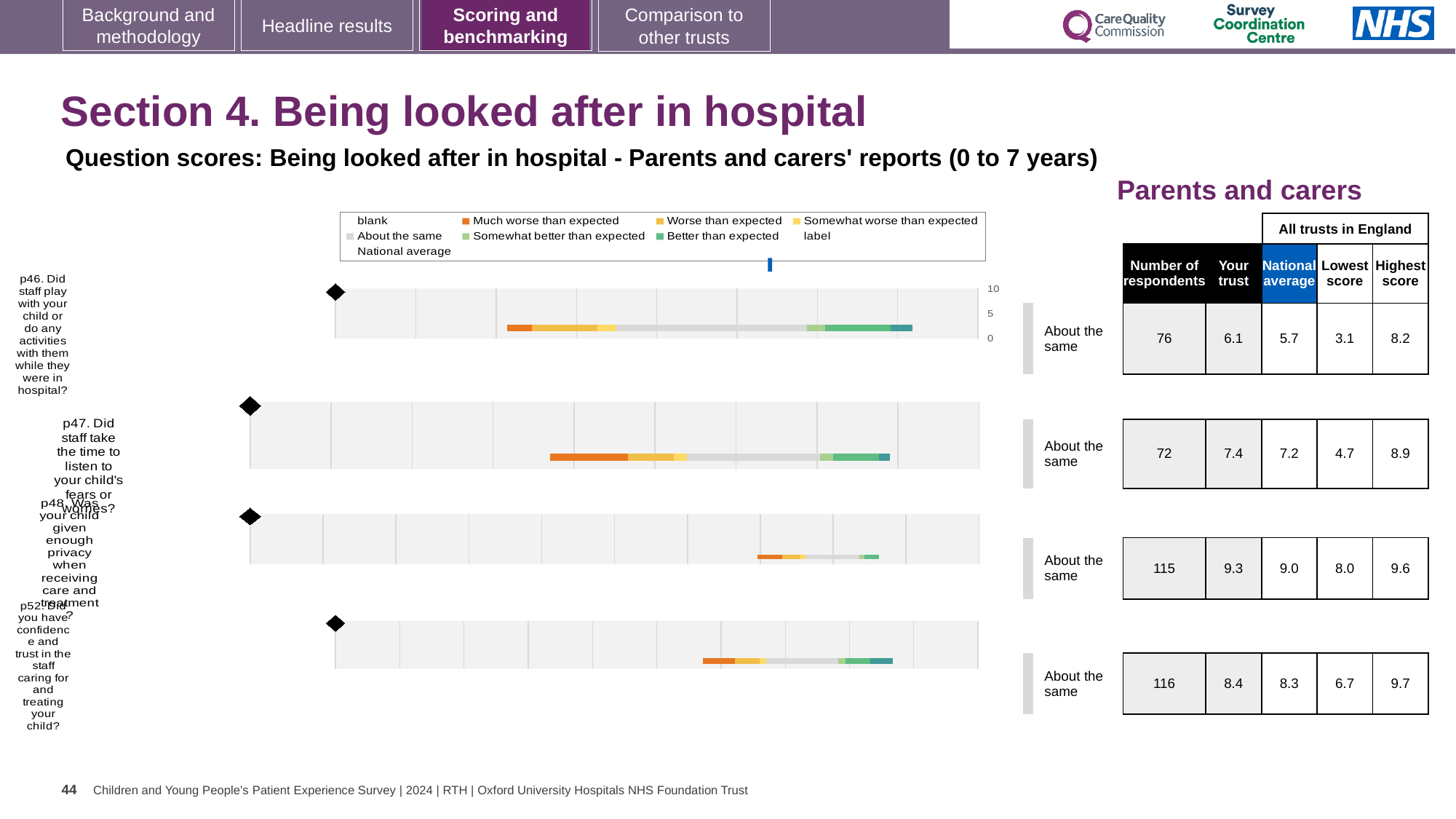
What is the 'Your trust' score for p47 (Did staff take the time to listen to your child's fears or worries?)? 7.4 For p46, what is the difference between the highest score and the lowest score among all trusts in England? 5.1 For p52, which is larger: the 'Your trust' score or the national average? Your trust (8.4) How many respondents answered p46 (Did staff play with your child or do any activities with them while they were in hospital?)? 76 For p47, how much higher is the 'Your trust' score than the national average? 0.2 What kind of chart is used for each question on the slide? Bar chart Which question has the lowest 'Your trust' score? p46 (6.1) Which question has the highest 'Your trust' score? p48 (9.3) What is the highest score among all trusts in England for p52 (Did you have confidence and trust in the staff caring for and treating your child?)? 9.7 How many question charts are shown on the slide? 4 What benchmark category is shown next to the chart for p46? About the same What is the national average score for p48 (Was your child given enough privacy when receiving care and treatment?)? 9.0